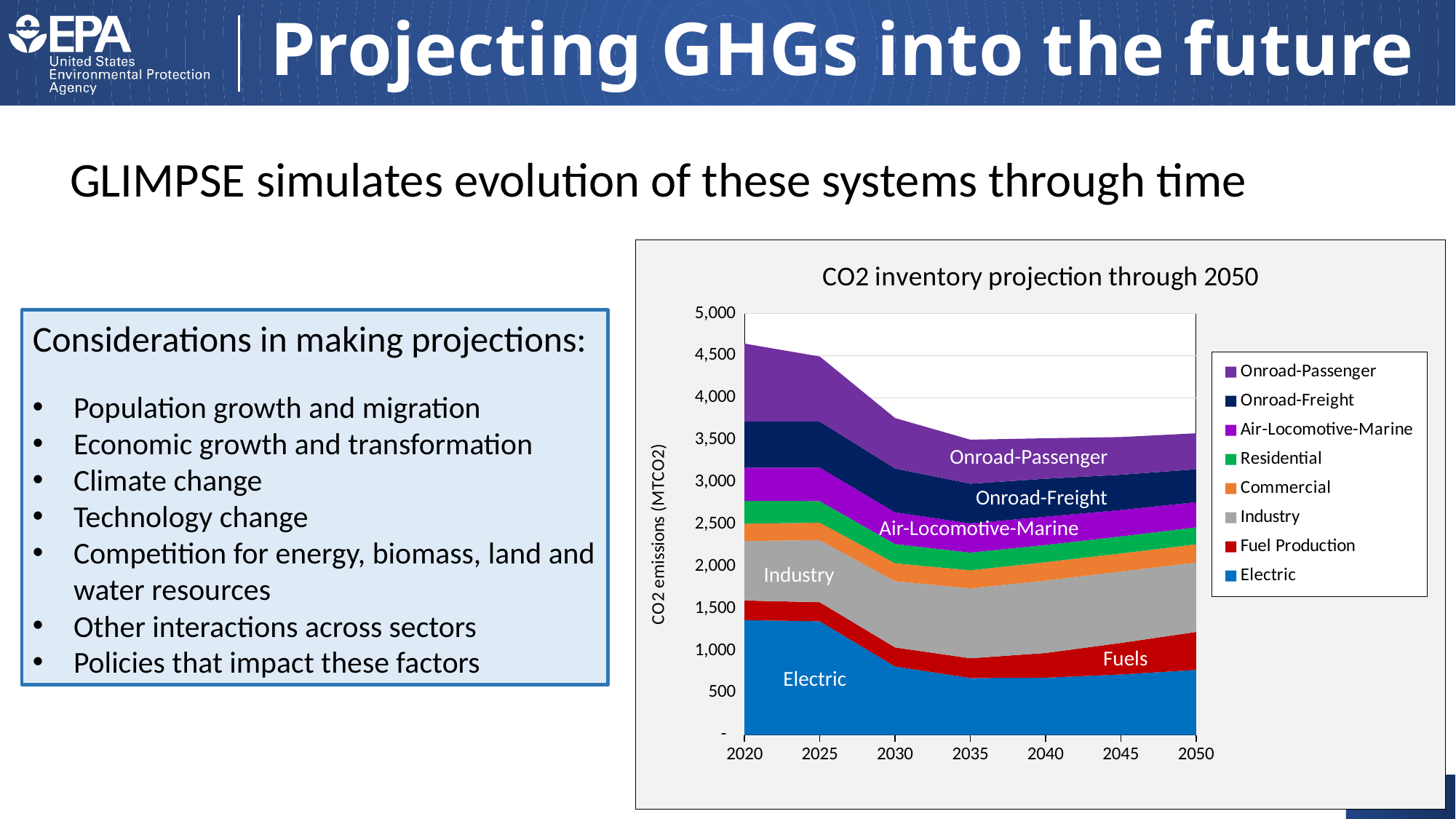
Is the total CO2 emissions value in 2020 greater or less than 4,000? greater How many years are labelled on the x axis of the chart? 7 Is the Electric value in 2020 greater or less than 1,000? greater How many series does the legend of the chart list? 8 What is the label of the y axis of the chart? CO2 emissions (MTCO2) What kind of chart is shown on the slide? stacked area chart Which is larger, the total CO2 emissions in 2020 or in 2050? 2020 Is the Electric value in 2050 greater or less than 1,000? less Do total CO2 emissions rise or fall between 2020 and 2035? fall Which year has the highest total CO2 emissions in the chart? 2020 What is the title of the chart? CO2 inventory projection through 2050